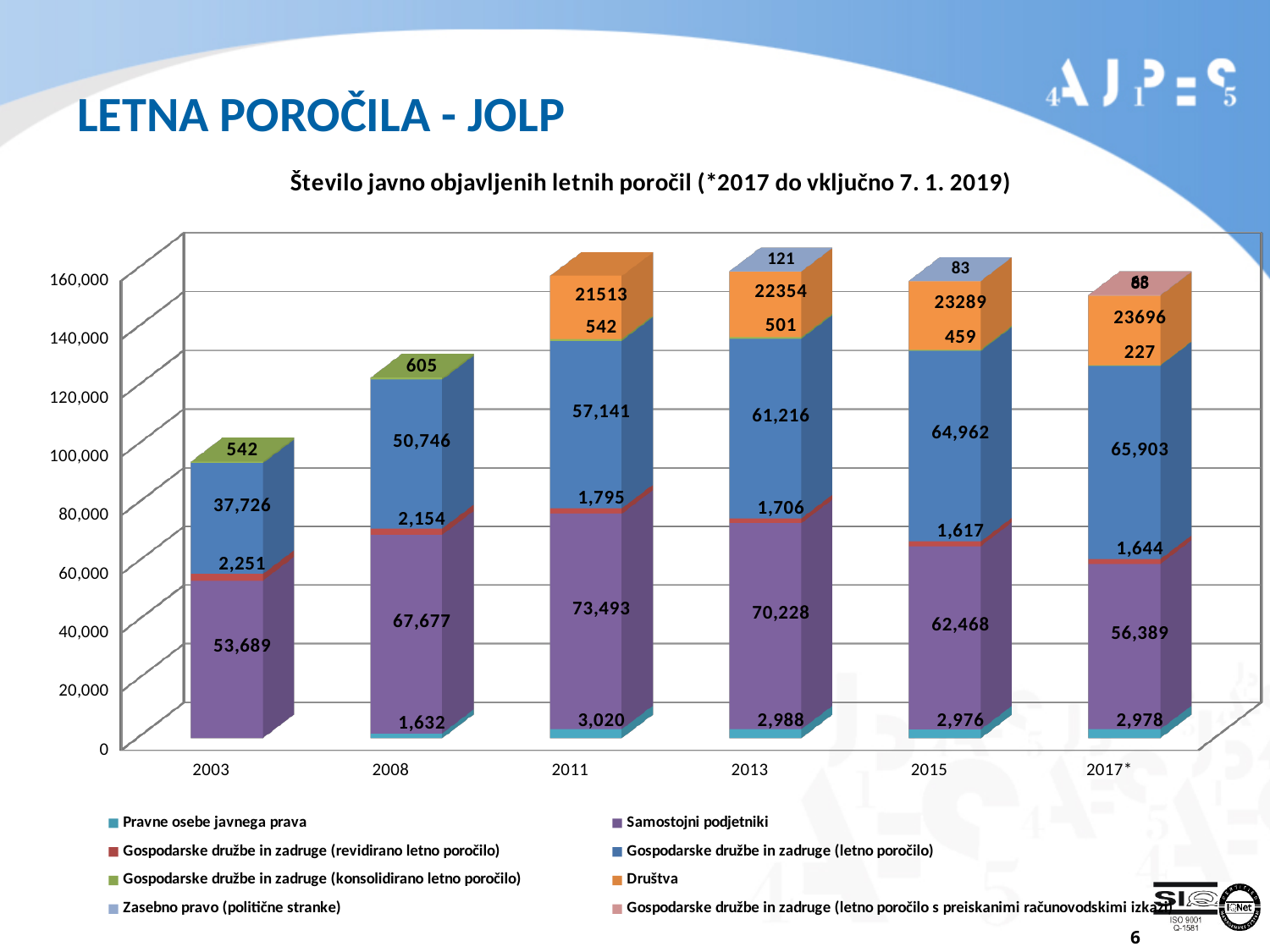
What is the difference between the Samostojni podjetniki values for 2008 and 2003? 13,988 What is the value for Gospodarske družbe in zadruge (letno poročilo) in 2017*? 65,903 What is the value for Društva in 2013? 22354 Does the value for Gospodarske družbe in zadruge (letno poročilo) rise or fall from 2003 to 2017*? Rises What is the value for Samostojni podjetniki in 2011? 73,493 In 2015, which is larger: Samostojni podjetniki or Gospodarske družbe in zadruge (letno poročilo)? Gospodarske družbe in zadruge (letno poročilo) What kind of chart is shown on the slide? Stacked bar chart In which year is the value for Samostojni podjetniki the highest? 2011 In which year is the value for Gospodarske družbe in zadruge (letno poročilo) the lowest? 2003 What is the value for Pravne osebe javnega prava in 2008? 1,632 How many years are shown on the x axis? 6 How many series does the legend list? 8